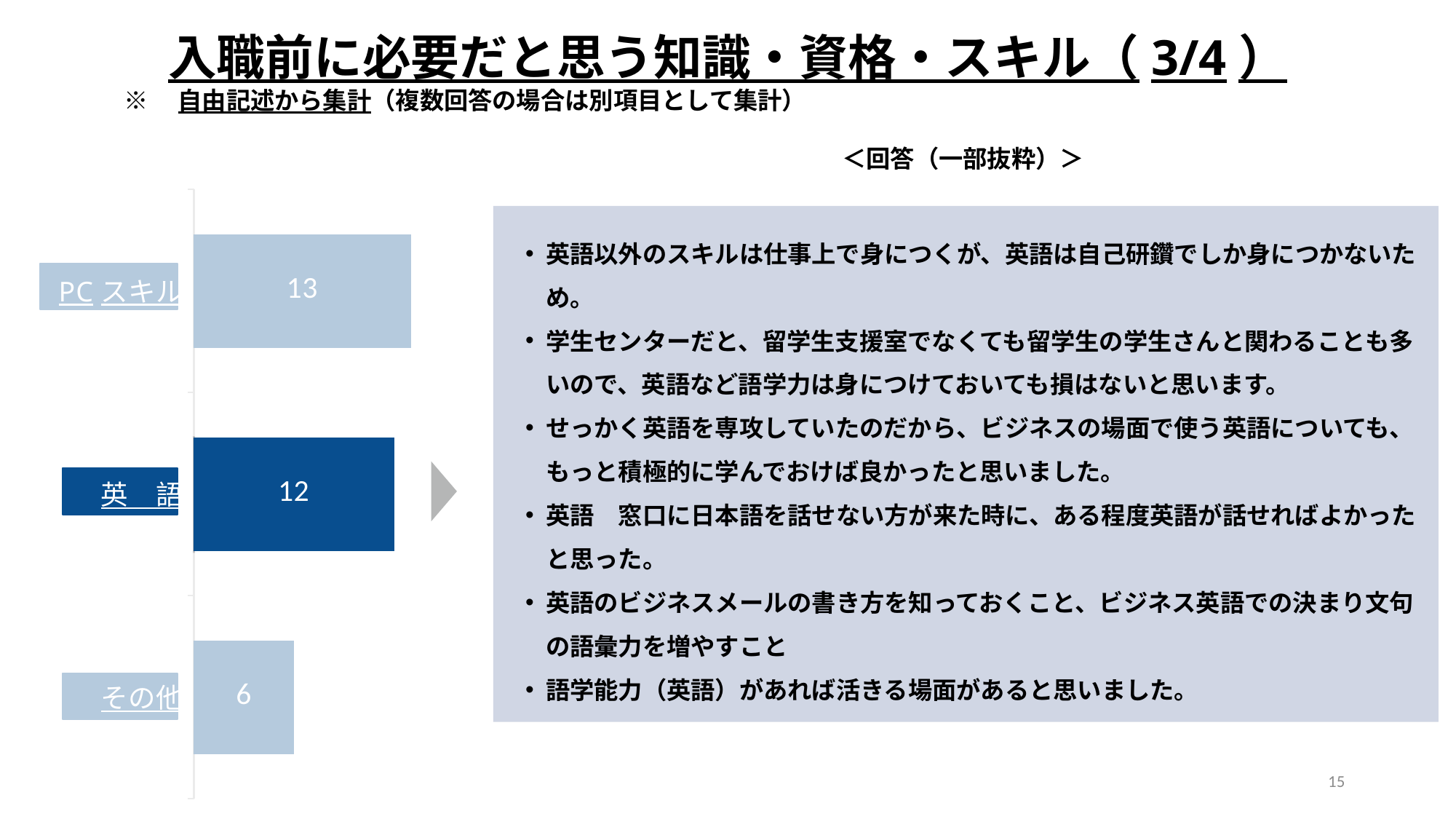
Which category's bar is shown in a darker blue than the others? 英語 Which category has the highest value? PC スキル What is the value for PC スキル? 13 How many categories are shown in the chart? 3 What is the difference between the values for PC スキル and その他? 7 What is the difference between the values for 英語 and その他? 6 Which is larger, the value for 英語 or the value for その他? 英語 What kind of chart is shown on the slide? bar chart What is the value for その他? 6 What is the value for 英語? 12 What is the total of the three values shown in the chart? 31 Which category has the lowest value? その他